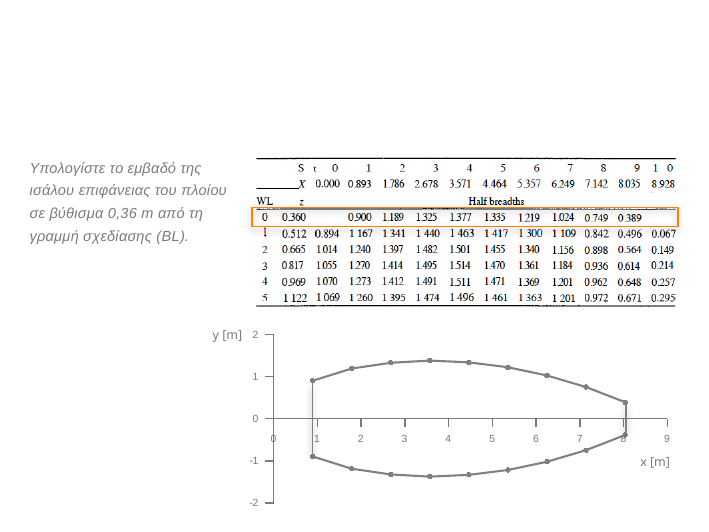
Is the plotted shape symmetric about the horizontal axis (y = 0)? yes Is the highest y value plotted on the chart greater or less than 2? less Is the lowest y value plotted on the chart greater or less than -1? less Along the upper curve, do the y values rise or fall as x increases from about 4 to about 8? fall Along the upper curve, do the y values rise or fall as x increases from about 1 to about 3.5? rise Is the largest x value of the plotted points greater or less than 9? less What is the label of the vertical axis of the chart? y [m] What is the label of the horizontal axis of the chart? x [m] What kind of chart is shown on the slide? line chart with markers